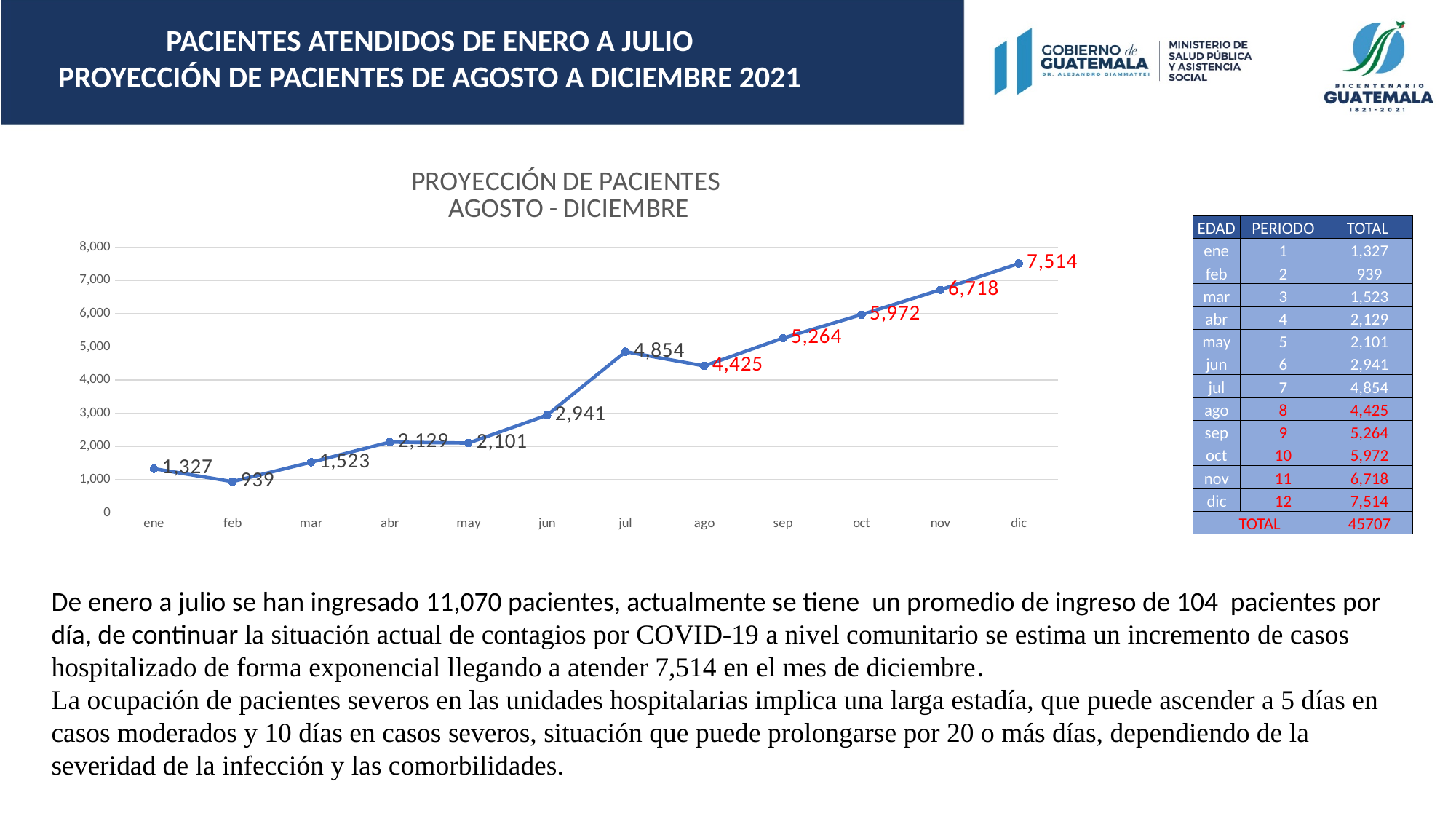
Which is larger, the value for abr or the value for may? abr What is the title of the chart? PROYECCIÓN DE PACIENTES AGOSTO - DICIEMBRE Which month has the lowest value in the chart? feb Which month has the highest value in the chart? dic How many months are plotted on the x axis of the chart? 12 What kind of chart is shown on the slide? line chart What is the difference between the values for jul and ago? 429 Is the value for oct greater or less than 5,000? greater What is the value for feb in the chart? 939 What is the difference between the values for dic and nov? 796 What is the value for dic in the chart? 7,514 What is the value for jul in the chart? 4,854